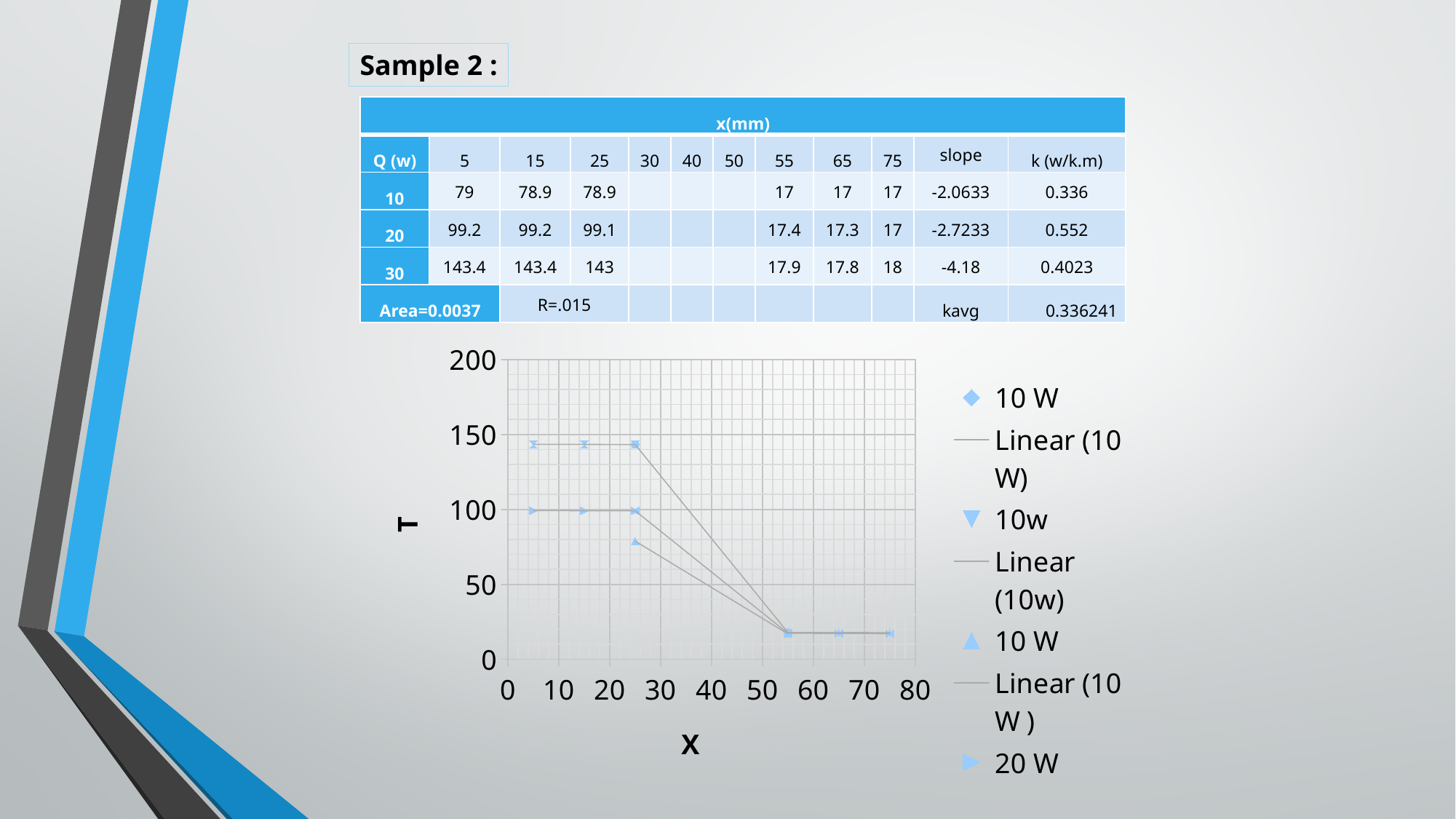
What is the title of the vertical axis of the chart? T Is the value of the lowest plotted point at x = 25 greater or less than 100? less Is the value of the plotted points at x = 55 greater or less than 50? less Is the value of the topmost series at x = 25 greater or less than 150? less At x = 25, which is larger: the topmost series or the middle series? the topmost series What is the highest tick value shown on the vertical axis? 200 Do the plotted values rise or fall as x increases from 25 to 55? fall What kind of chart is shown on the slide? scatter chart What is the title of the horizontal axis of the chart? X